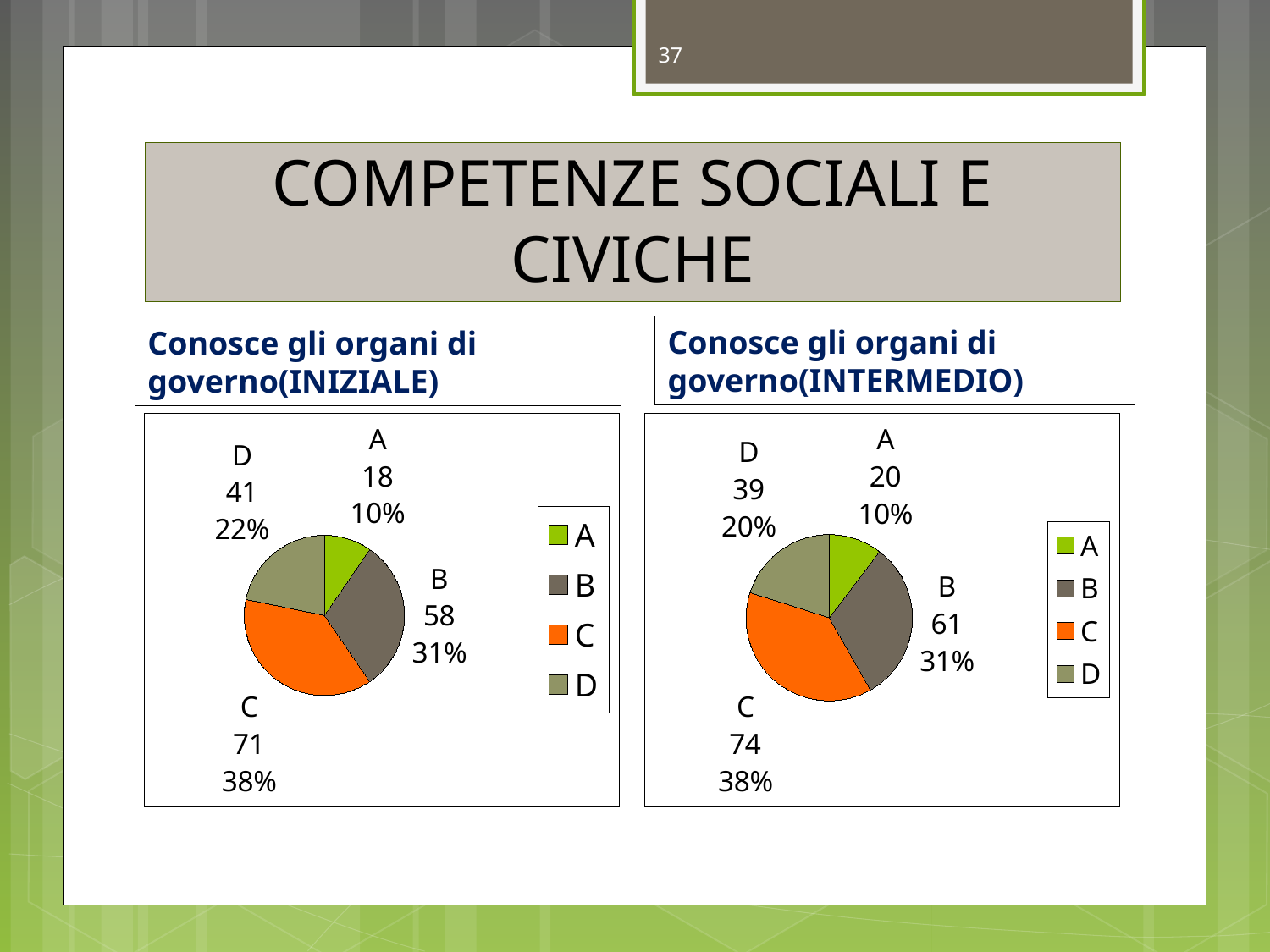
In the 'Conosce gli organi di governo(INIZIALE)' chart, which category has the largest slice? C In the 'Conosce gli organi di governo(INTERMEDIO)' chart, what percentage share does C have? 38% In the 'Conosce gli organi di governo(INIZIALE)' chart, which is larger, the value for B or the value for D? B In the 'Conosce gli organi di governo(INTERMEDIO)' chart, which category has the smallest slice? A What kind of chart is the 'Conosce gli organi di governo(INIZIALE)' chart? Pie chart In the 'Conosce gli organi di governo(INIZIALE)' chart, what percentage share does D have? 22% In the 'Conosce gli organi di governo(INTERMEDIO)' chart, what is the difference between the values for D and A? 19 In the 'Conosce gli organi di governo(INTERMEDIO)' chart, which colour represents category C in the legend? Orange In the 'Conosce gli organi di governo(INIZIALE)' chart, what is the value for C? 71 In the 'Conosce gli organi di governo(INIZIALE)' chart, what is the difference between the values for C and B? 13 How many categories does the 'Conosce gli organi di governo(INTERMEDIO)' chart show? 4 In the 'Conosce gli organi di governo(INTERMEDIO)' chart, what is the value for B? 61